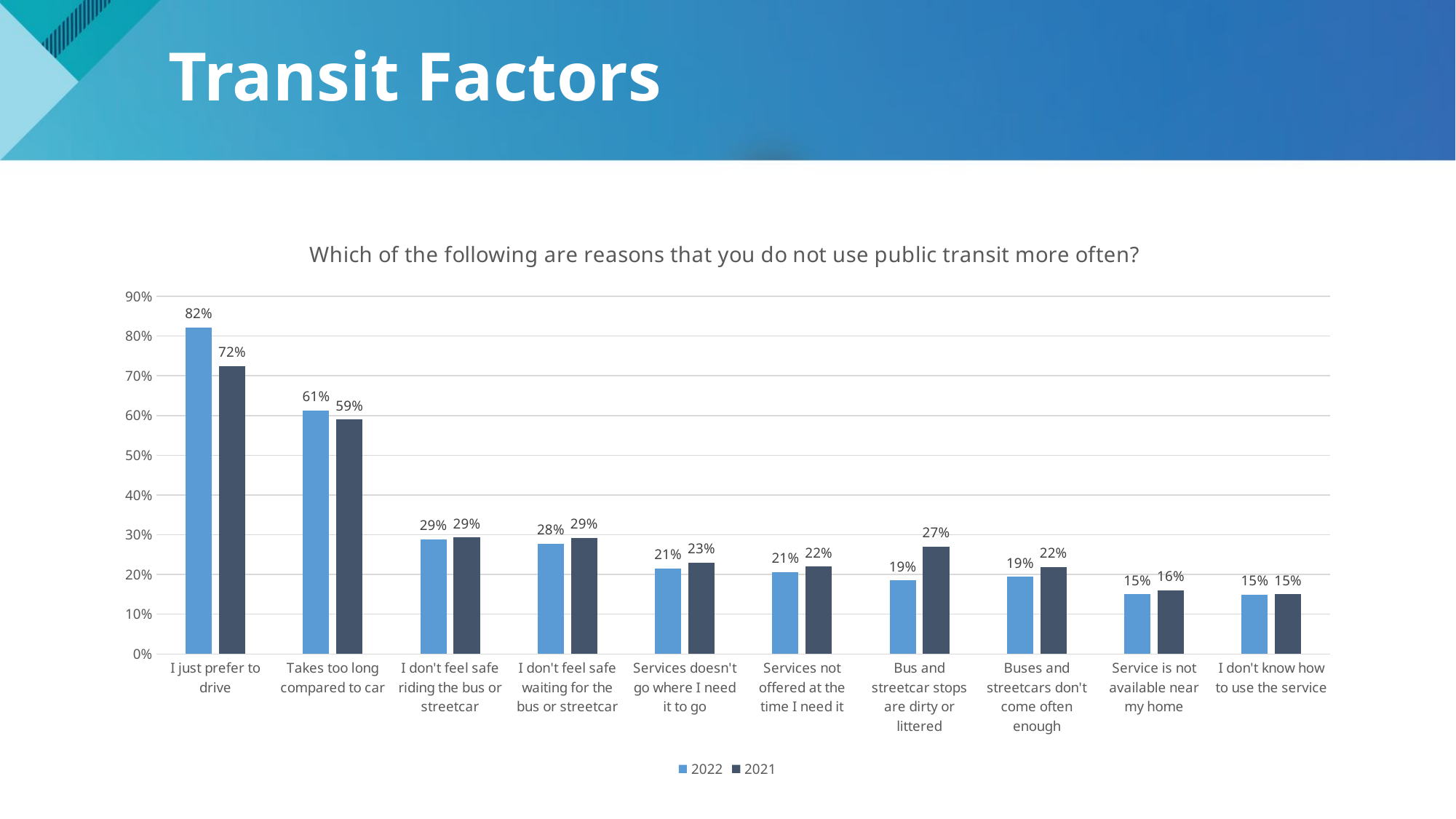
What kind of chart is shown on the slide? Bar chart How many categories are shown on the x axis? 10 How many series does the legend list? 2 What is the title of the chart? Which of the following are reasons that you do not use public transit more often? What is the 2021 value for "Bus and streetcar stops are dirty or littered"? 27% Is the 2022 value for "Takes too long compared to car" greater or less than 50%? greater What is the 2021 value for "Takes too long compared to car"? 59% Which category has the highest 2022 value? I just prefer to drive What is the 2022 value for "I just prefer to drive"? 82% Which category has the lowest 2021 value? I don't know how to use the service What is the difference between the 2022 and 2021 values for "I just prefer to drive"? 10% Which is larger for "Bus and streetcar stops are dirty or littered": the 2022 value or the 2021 value? 2021